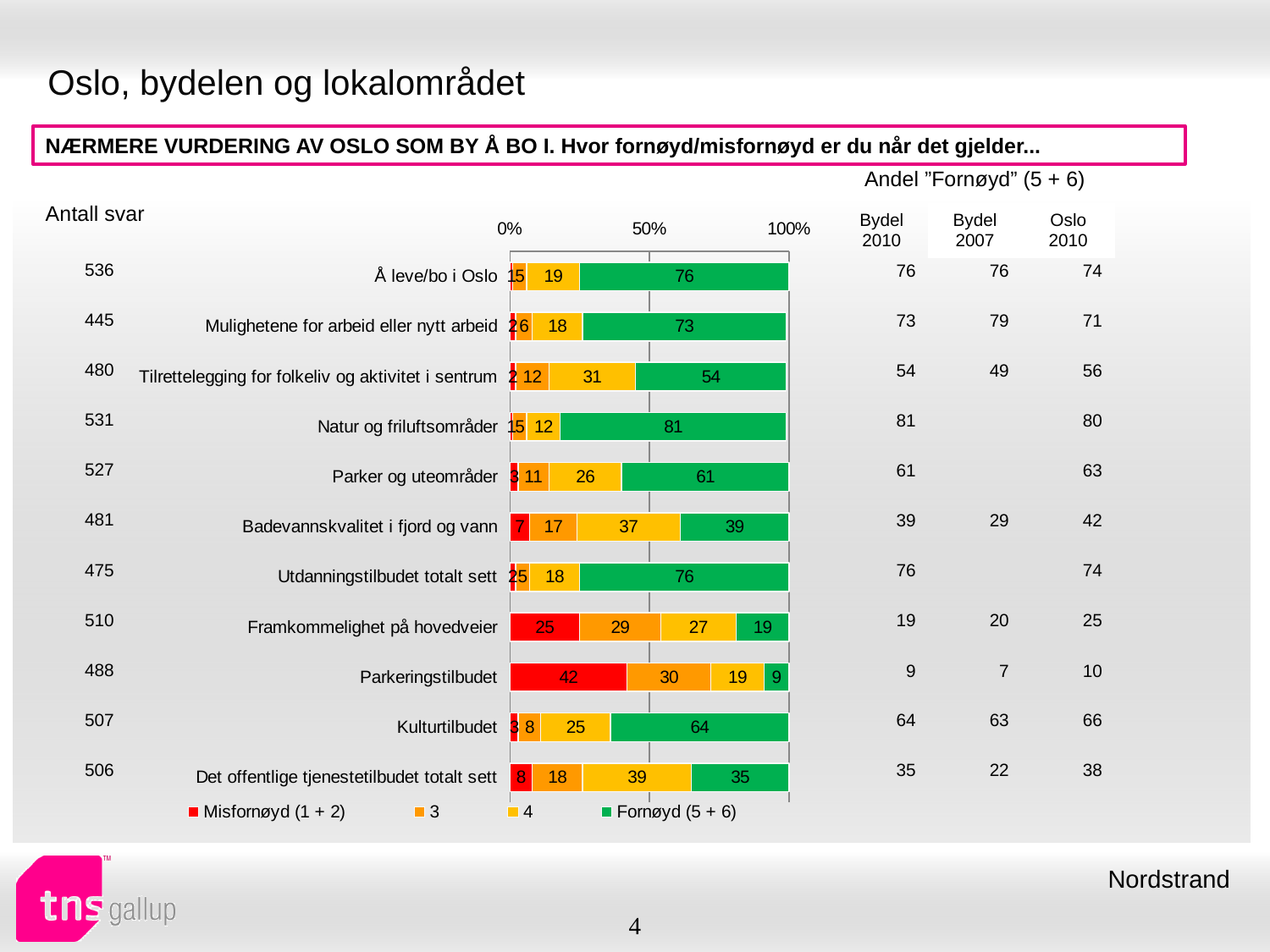
What is the difference between the Fornøyd (5 + 6) values for Natur og friluftsområder and Å leve/bo i Oslo? 5 What is the first entry in the chart legend? Misfornøyd (1 + 2) Which has a larger Fornøyd (5 + 6) value: Kulturtilbudet or Parker og uteområder? Kulturtilbudet How many series does the chart legend list? 4 What type of chart is shown on the slide? bar chart What is the Fornøyd (5 + 6) value for Det offentlige tjenestetilbudet totalt sett? 35 How many categories are plotted in the chart? 11 What is the Misfornøyd (1 + 2) value for Parkeringstilbudet? 42 What is the total of the stacked bar for Framkommelighet på hovedveier? 100 Which category has the highest Fornøyd (5 + 6) value? Natur og friluftsområder What is the Fornøyd (5 + 6) value for Natur og friluftsområder? 81 Which category has the lowest Fornøyd (5 + 6) value? Parkeringstilbudet